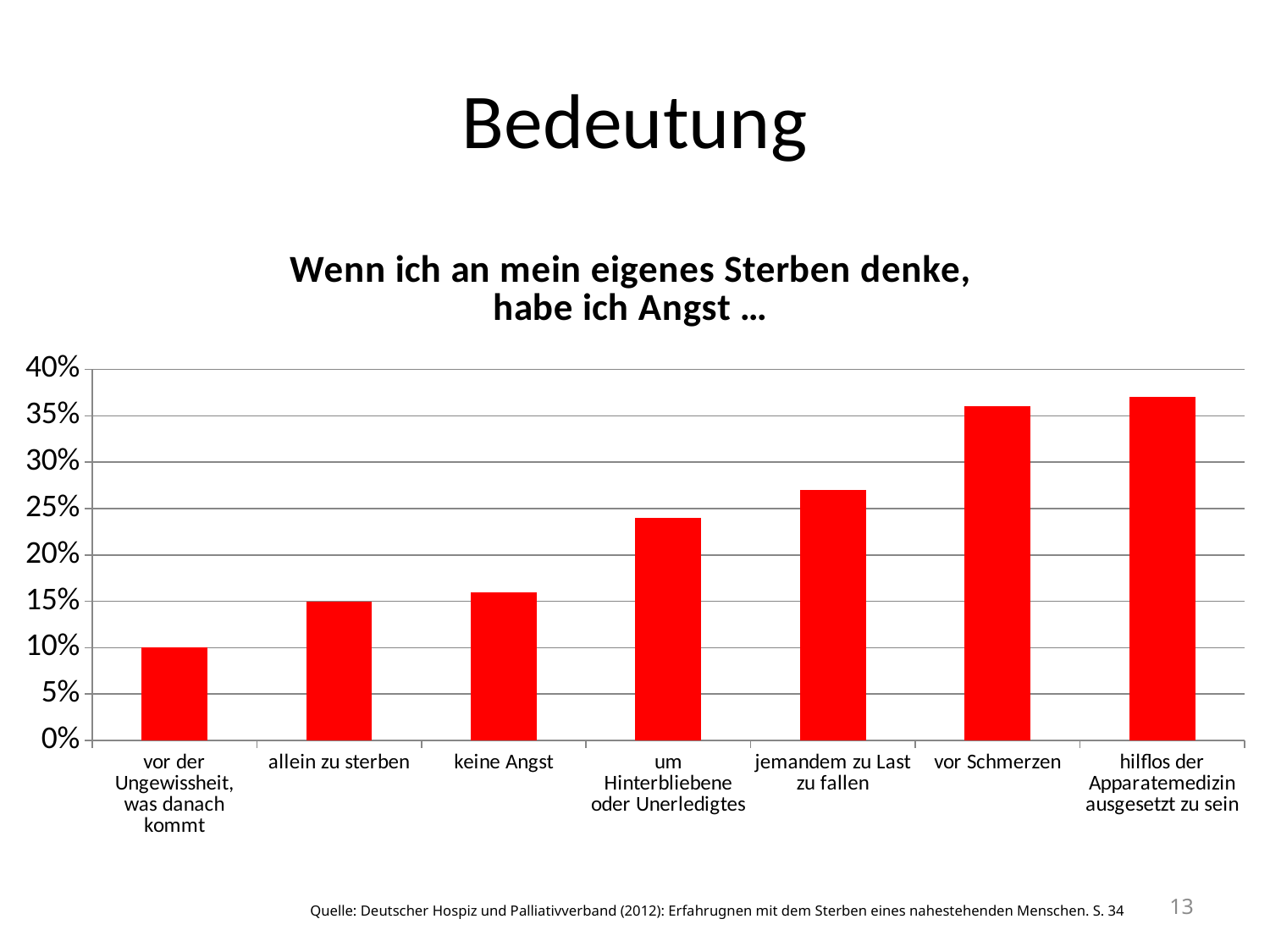
What is the value for "vor der Ungewissheit, was danach kommt"? 10% Is the value for "jemandem zu Last zu fallen" greater or less than 25%? greater Is the value for "um Hinterbliebene oder Unerledigtes" greater or less than 20%? greater What is the value for "allein zu sterben"? 15% Is the value for "keine Angst" greater or less than 20%? less What kind of chart is shown on the slide? bar chart How many categories are shown on the x axis of the chart? 7 What is the title of the chart? Wenn ich an mein eigenes Sterben denke, habe ich Angst … Which category has the lowest value? vor der Ungewissheit, was danach kommt Do the values rise or fall from left to right along the x axis? rise Which is larger, the value for "vor Schmerzen" or the value for "jemandem zu Last zu fallen"? vor Schmerzen